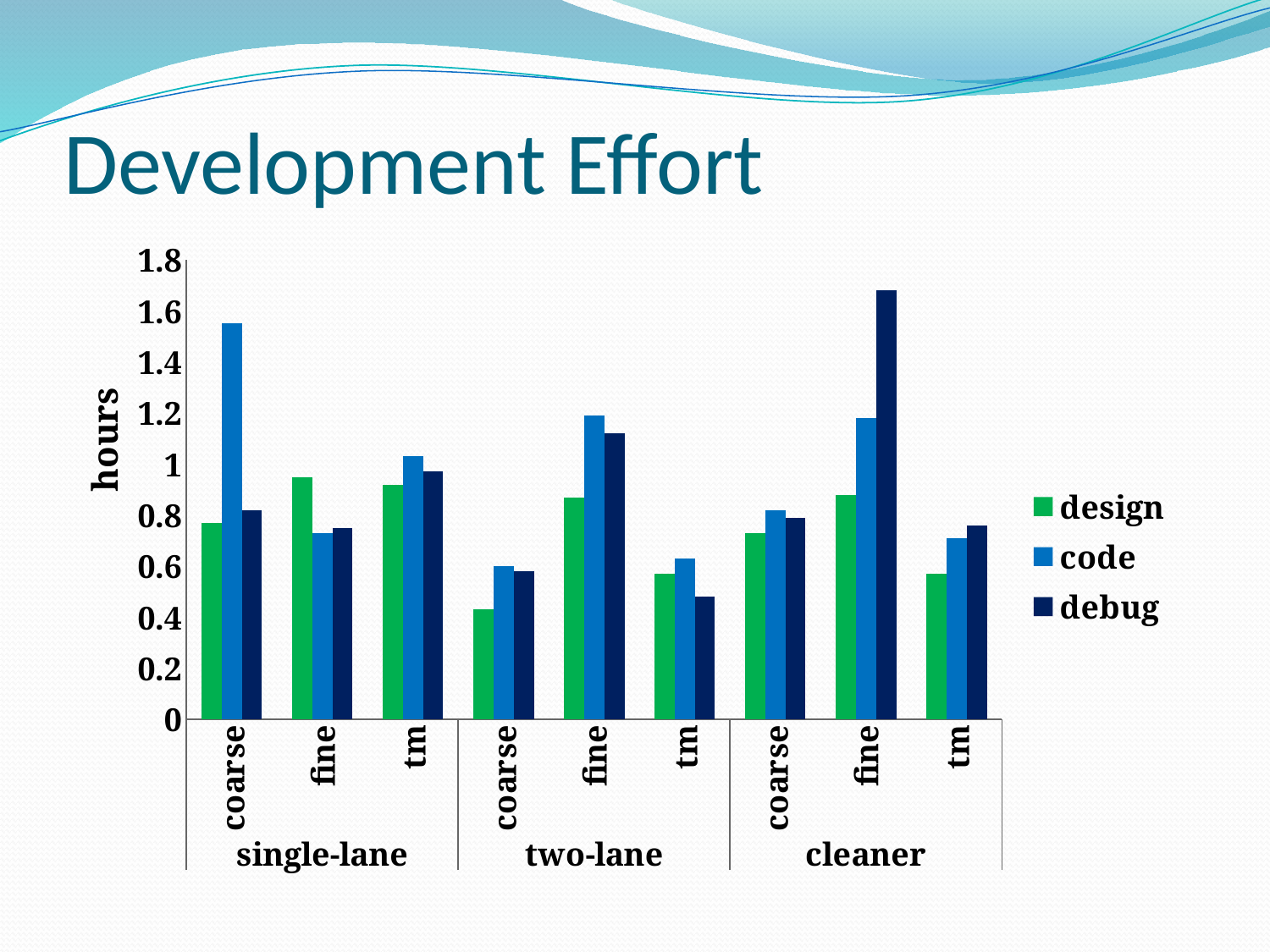
Is the debug value for cleaner fine greater or less than 1.6 hours? greater What is the label on the y axis? hours What are the three series named in the legend? design, code, debug What kind of chart is shown on the slide? bar chart Which category has the lowest design value? two-lane coarse For single-lane coarse, which is larger: code or debug? code Which category and series has the tallest bar in the chart? debug for cleaner fine Is the design value for two-lane coarse greater or less than 0.6 hours? less Is the code value for single-lane coarse greater or less than 1.4 hours? greater How many category groups (coarse/fine/tm combinations) are plotted along the x axis? 9 How many series does the legend list? 3 For single-lane fine, which is larger: design or code? design